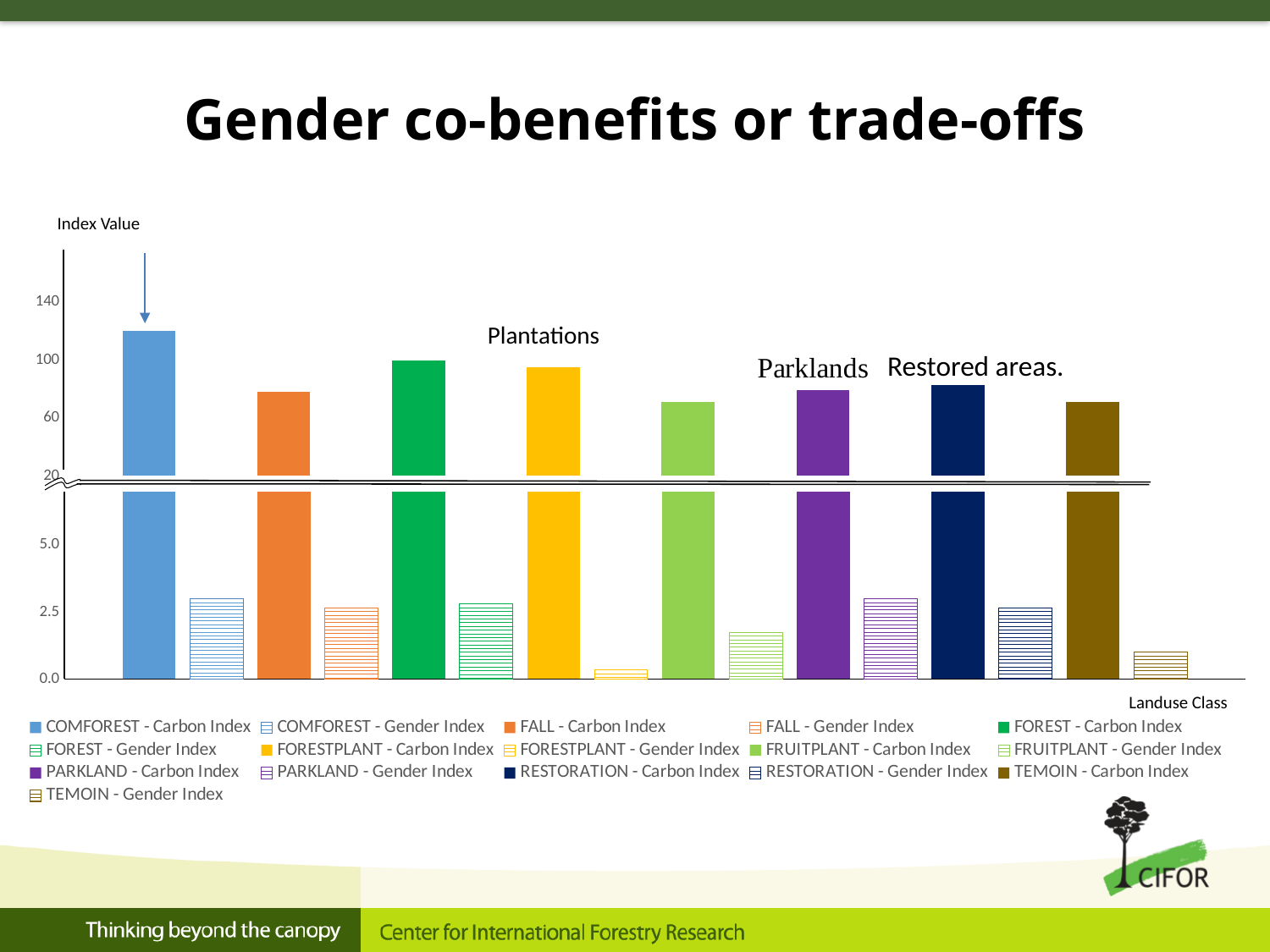
What is the label of the vertical axis? Index Value Which is larger, the Gender Index for PARKLAND or the Gender Index for TEMOIN? PARKLAND - Gender Index How many series does the legend list? 16 Is the value for COMFOREST - Carbon Index greater or less than 100? greater Which is larger, the Carbon Index for FOREST or the Carbon Index for FRUITPLANT? FOREST - Carbon Index Which series has the highest bar in the chart? COMFOREST - Carbon Index What kind of chart is shown on the slide? Bar chart Which series has the lowest bar in the chart? FORESTPLANT - Gender Index Is the value for FRUITPLANT - Gender Index greater or less than 2.5? less Is the value for FALL - Carbon Index greater or less than 100? less What is the title of the slide's chart? Gender co-benefits or trade-offs